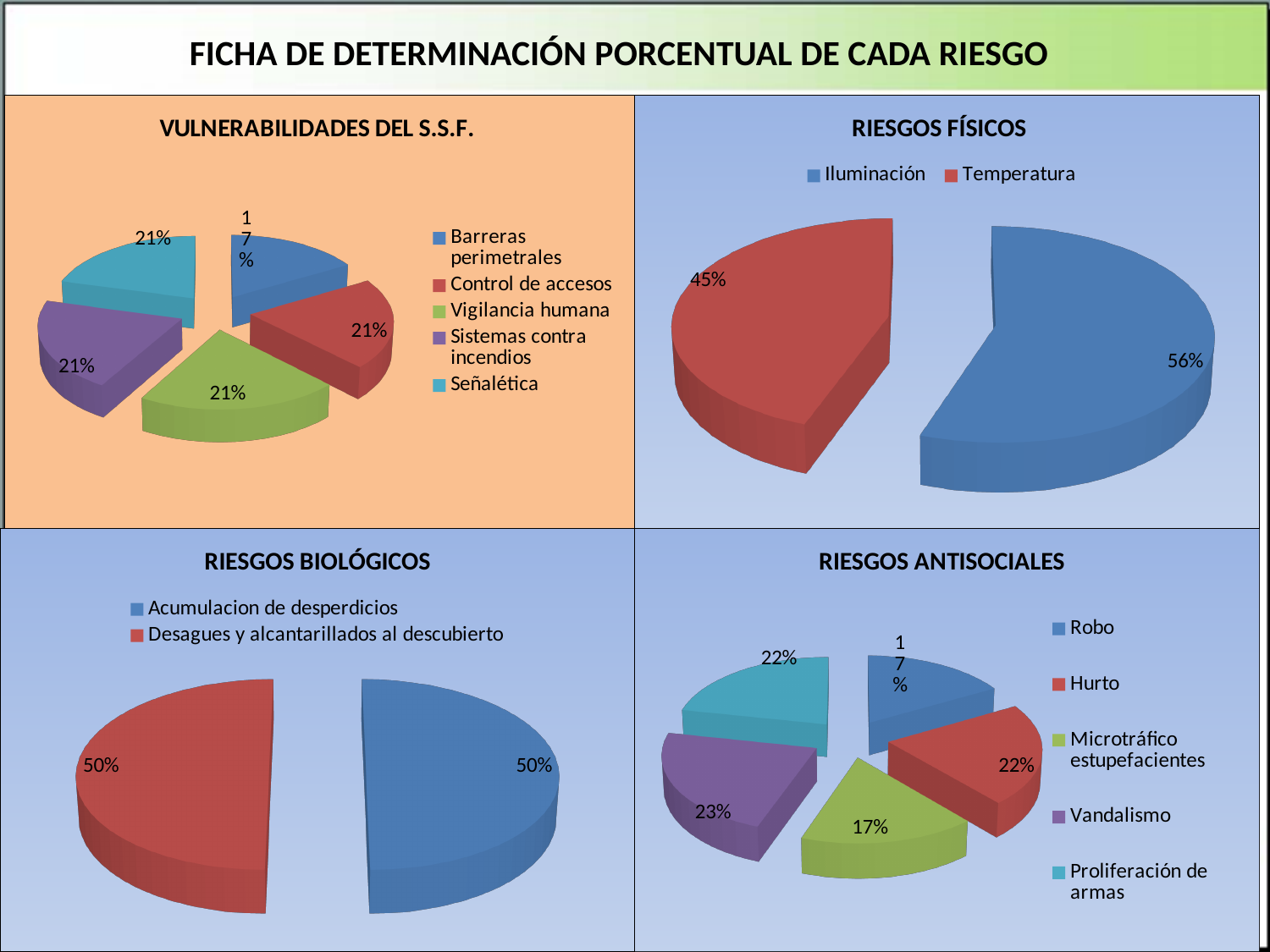
In the VULNERABILIDADES DEL S.S.F. chart, what percentage is shown for Barreras perimetrales? 17% In the RIESGOS FÍSICOS chart, which is larger, Iluminación or Temperatura? Iluminación What type of chart is the RIESGOS BIOLÓGICOS chart? Pie chart In the RIESGOS FÍSICOS chart, what percentage is shown for Iluminación? 56% In the RIESGOS ANTISOCIALES chart, which category has the largest slice? Vandalismo In the VULNERABILIDADES DEL S.S.F. chart, which category has the smallest slice? Barreras perimetrales In the RIESGOS FÍSICOS chart, what percentage is shown for Temperatura? 45% In the RIESGOS ANTISOCIALES chart, what percentage is shown for Hurto? 22% In the RIESGOS FÍSICOS chart, what is the difference in percentage points between Iluminación and Temperatura? 11 How many categories does the RIESGOS ANTISOCIALES chart show? 5 How many entries does the legend of the RIESGOS BIOLÓGICOS chart list? 2 In the RIESGOS ANTISOCIALES chart, what percentage is shown for Vandalismo? 23%